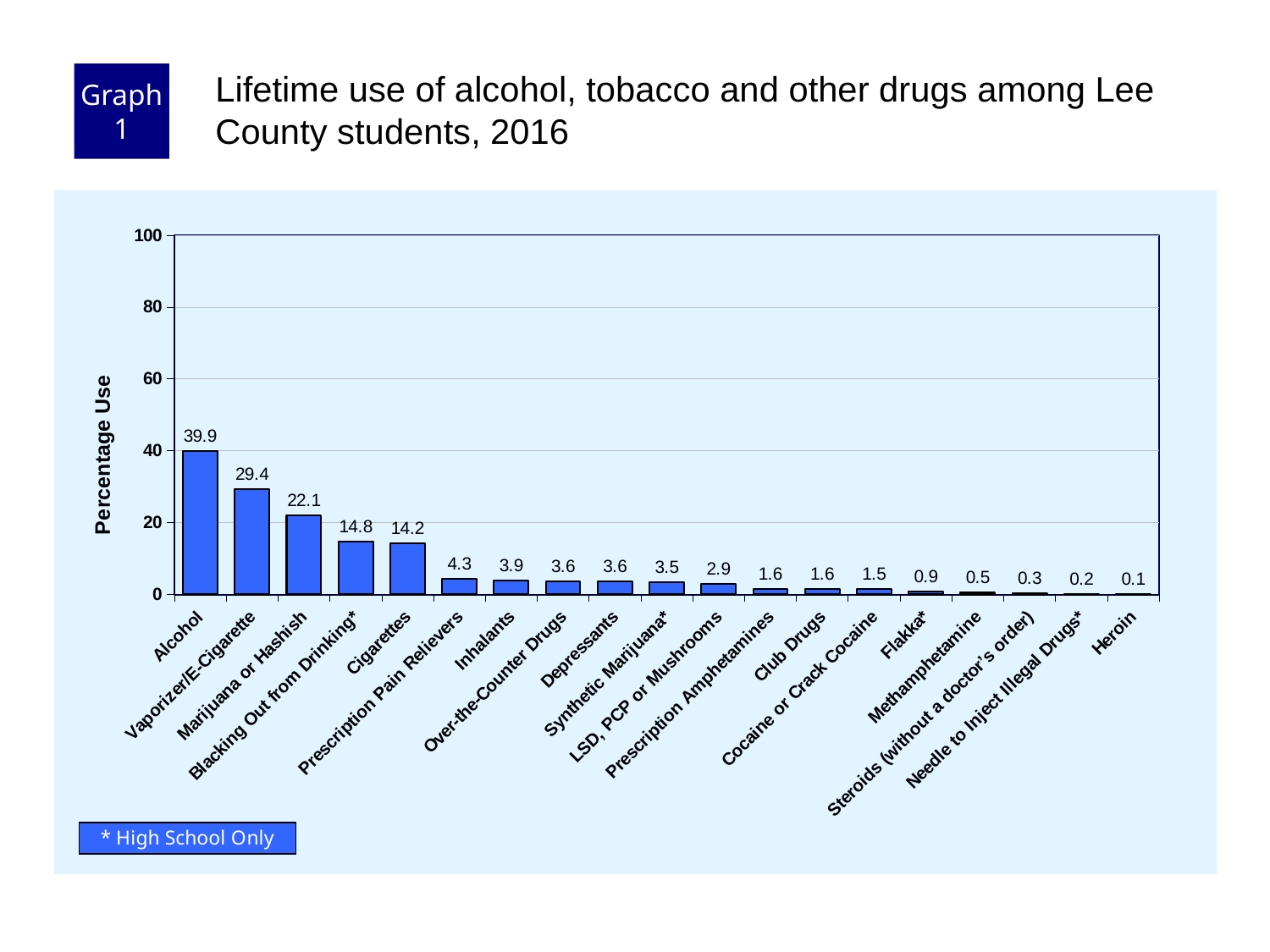
Which category has the highest percentage use? Alcohol Is the value for Vaporizer/E-Cigarette greater or less than 20? greater What is the percentage use for Methamphetamine? 0.5 What is the percentage use for Cigarettes? 14.2 Which category has the lowest percentage use? Heroin Which has a higher percentage use, Marijuana or Hashish or Cigarettes? Marijuana or Hashish What is the percentage use for Inhalants? 3.9 What kind of chart is shown on the slide? Bar chart How many categories are shown on the chart? 19 What is the percentage use for Alcohol? 39.9 What is the difference in percentage use between Alcohol and Vaporizer/E-Cigarette? 10.5 What is the label of the y axis? Percentage Use